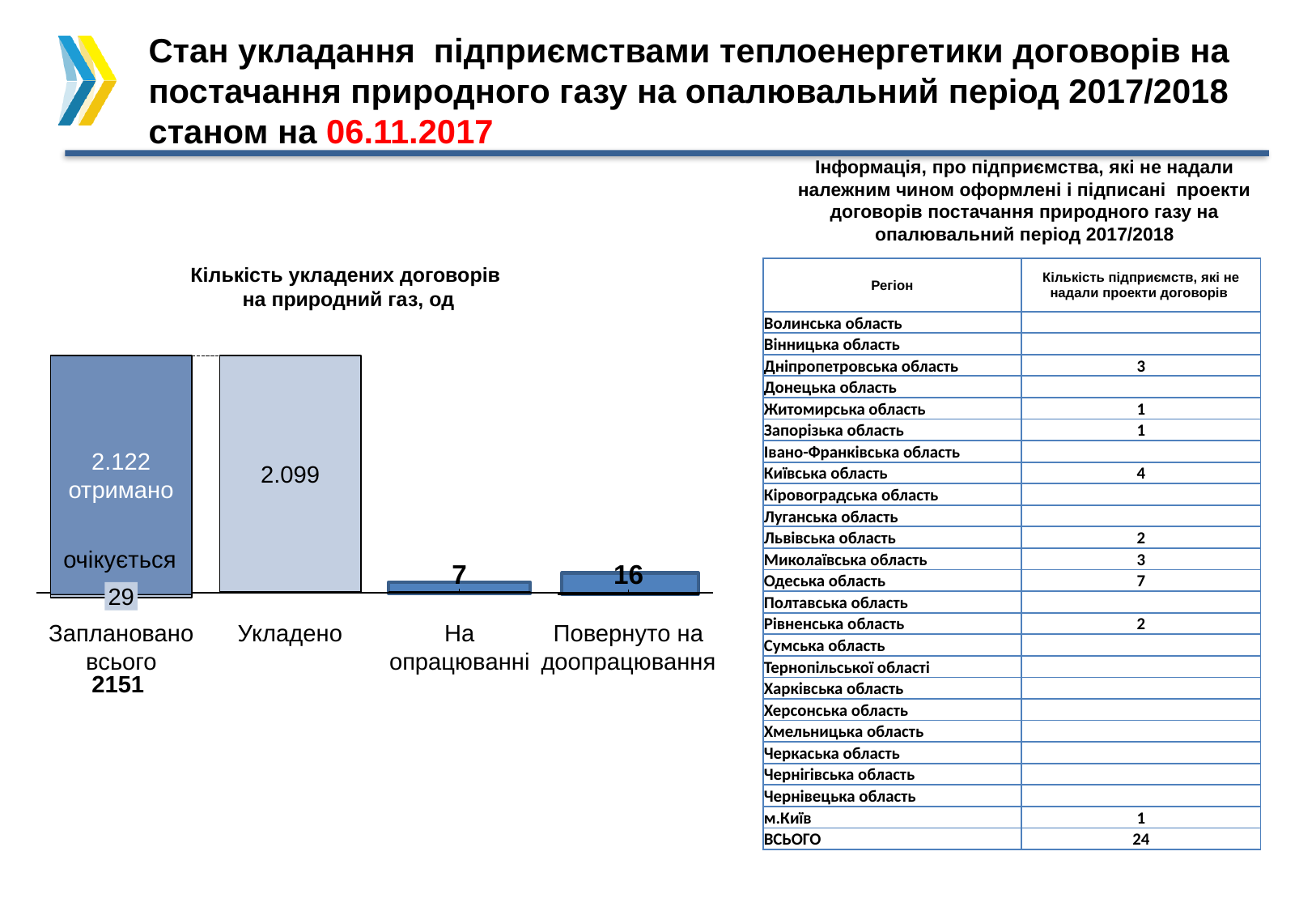
Which category has the highest value in the chart? Заплановано всього How many categories are shown on the x axis of the chart? 4 What is the value for Повернуто на доопрацювання in the chart? 16 What is the difference between the values for Повернуто на доопрацювання and На опрацюванні? 9 Which category has the lowest value in the chart? На опрацюванні In the Заплановано всього bar, what is the value labelled 'отримано'? 2.122 What is the value for Укладено in the chart 'Кількість укладених договорів на природний газ, од'? 2.099 In the Заплановано всього bar, what is the value labelled 'очікується'? 29 Which is larger: the value for Укладено or the value for Повернуто на доопрацювання? Укладено What is the value for На опрацюванні in the chart? 7 What is the total shown for the stacked bar Заплановано всього? 2151 What type of chart is shown on the slide? bar chart